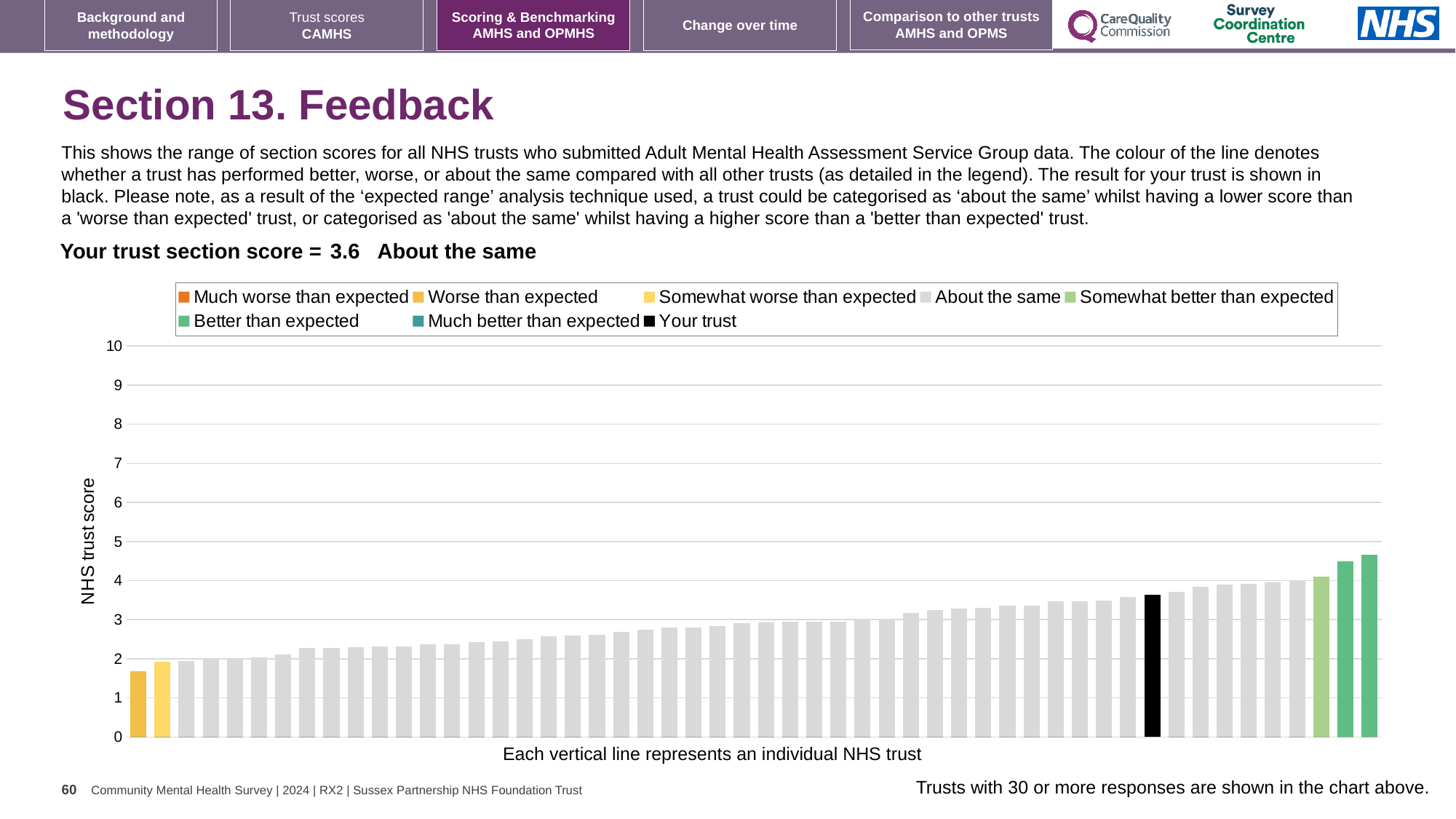
What kind of chart is shown on the slide? bar chart How many entries does the chart legend list? 8 Is the value of the black 'Your trust' bar greater or less than 3? greater Do the bar values rise or fall moving from left to right along the x axis? rise What is the label on the vertical axis of the chart? NHS trust score Which category is your trust's section score placed in? About the same What colour is the bar representing your trust? black Which is taller, the leftmost bar or the rightmost bar? the rightmost bar Is the value of the black 'Your trust' bar greater or less than 4? less Is the value of the leftmost bar greater or less than 2? less What is the section score for your trust shown on the slide? 3.6